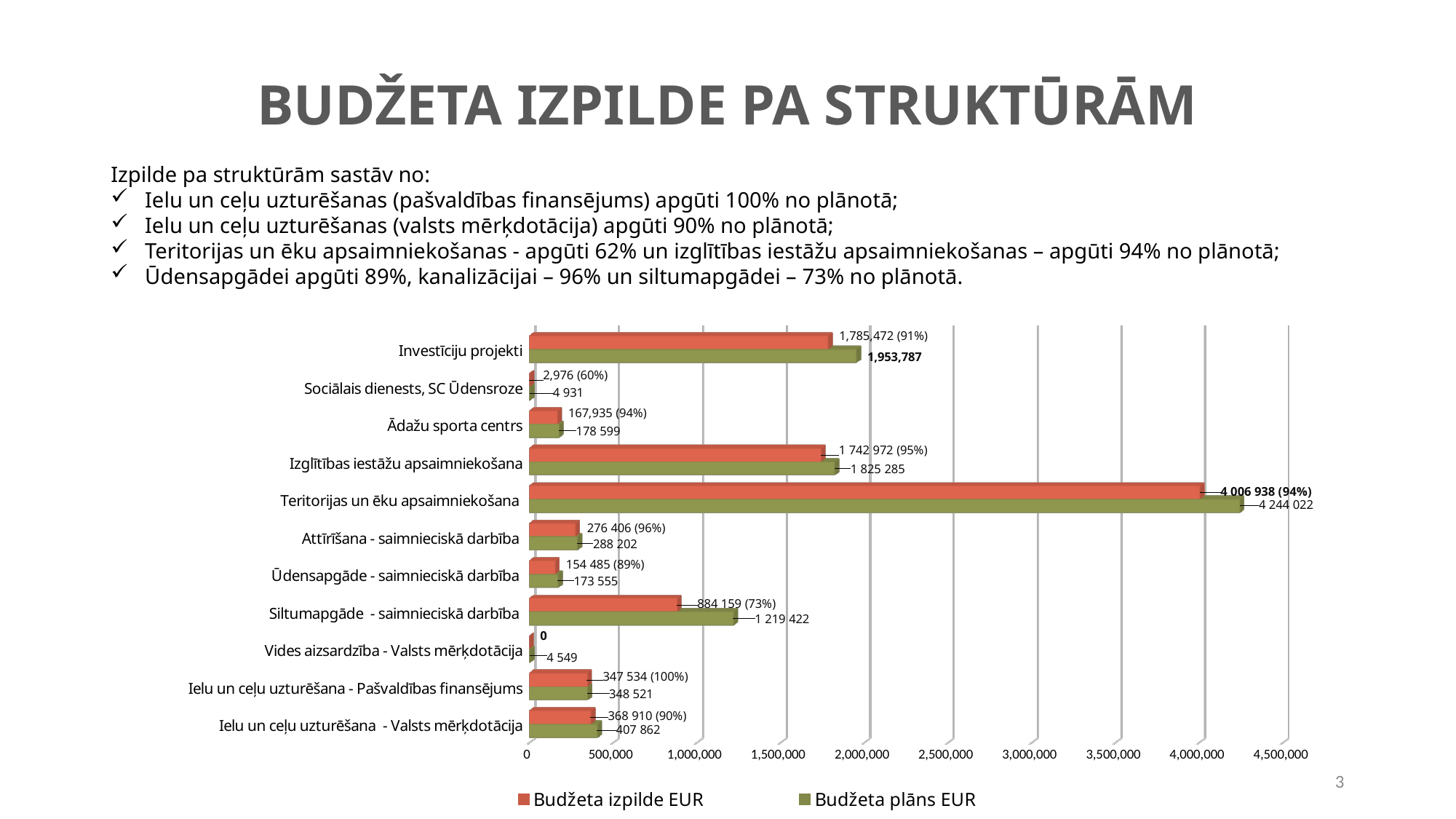
Which category has the highest Budžeta plāns EUR value? Teritorijas un ēku apsaimniekošana What is the Budžeta izpilde EUR value for Vides aizsardzība - Valsts mērķdotācija? 0 What is the difference between the Budžeta plāns EUR and Budžeta izpilde EUR values for Siltumapgāde - saimnieciskā darbība? 335 263 Is the Budžeta plāns EUR value for Teritorijas un ēku apsaimniekošana greater or less than 4,000,000? greater How many categories are shown on the chart? 11 Which category has the lowest Budžeta izpilde EUR value? Vides aizsardzība - Valsts mērķdotācija Which is larger: the Budžeta izpilde EUR value for Investīciju projekti or for Izglītības iestāžu apsaimniekošana? Investīciju projekti What is the Budžeta plāns EUR value for Siltumapgāde - saimnieciskā darbība? 1 219 422 What is the Budžeta plāns EUR value for Investīciju projekti? 1,953,787 How many series does the chart legend list? 2 What is the Budžeta izpilde EUR value for Teritorijas un ēku apsaimniekošana? 4 006 938 (94%) What kind of chart is shown on the slide? bar chart